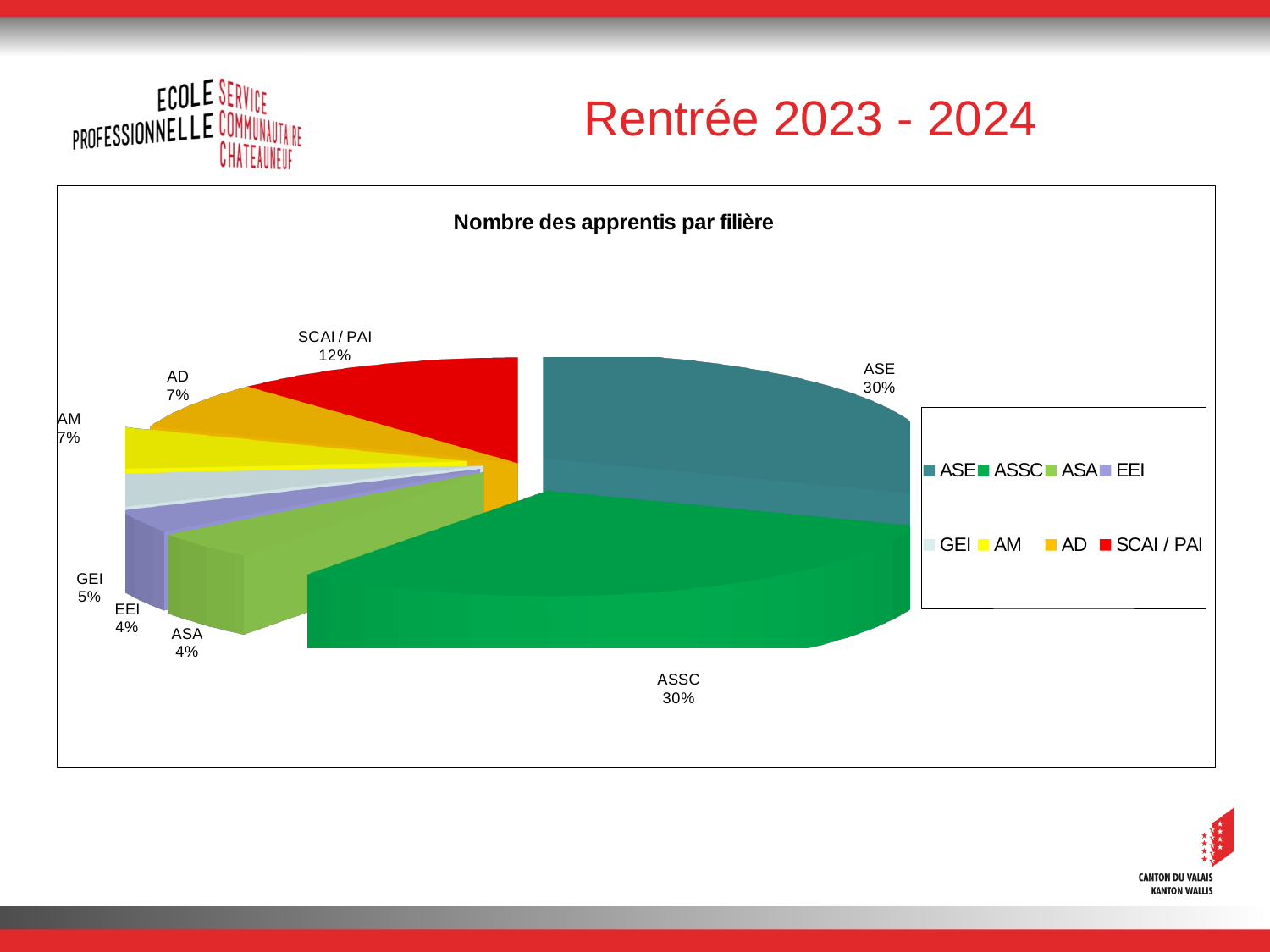
What percentage is shown for ASA? 4% What is the title of the chart? Nombre des apprentis par filière Which slice is larger, SCAI / PAI or AD? SCAI / PAI What percentage is shown for SCAI / PAI? 12% What is the combined share of ASE and ASSC? 60% What is the difference in percentage points between SCAI / PAI and GEI? 7% What share of the pie does the ASE slice represent? 30% What percentage is shown for AM? 7% How many entries does the legend list? 8 How many slices does the pie chart have? 8 What kind of chart is shown on the slide? pie chart What percentage is shown for GEI? 5%